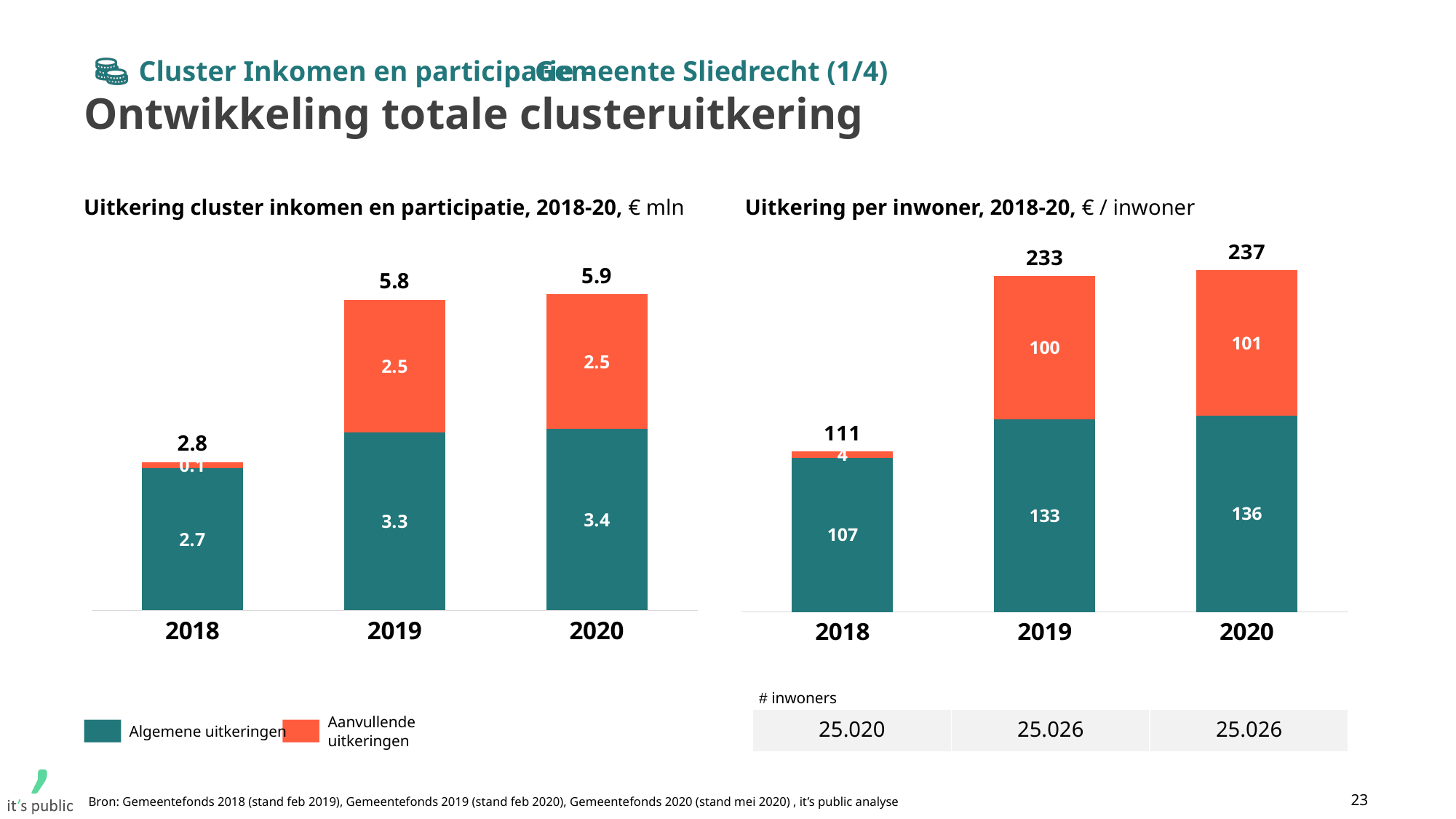
In the right chart 'Uitkering per inwoner, 2018-20', what is the difference between the totals for 2019 and 2018? 122 In the right chart 'Uitkering per inwoner, 2018-20', is the Algemene uitkeringen value for 2018 larger or smaller than the Aanvullende uitkeringen value for 2019? larger In the left chart 'Uitkering cluster inkomen en participatie, 2018-20', what is the total value for 2019? 5.8 How many years are shown on the x axis of the left chart 'Uitkering cluster inkomen en participatie, 2018-20'? 3 In the left chart 'Uitkering cluster inkomen en participatie, 2018-20', what is the value of Algemene uitkeringen for 2020? 3.4 In the left chart 'Uitkering cluster inkomen en participatie, 2018-20', what is the difference between the totals for 2020 and 2018? 3.1 What type of chart is the right chart 'Uitkering per inwoner, 2018-20'? Stacked bar chart In the right chart 'Uitkering per inwoner, 2018-20', which year has the highest total? 2020 In the right chart 'Uitkering per inwoner, 2018-20', what is the value of Aanvullende uitkeringen for 2020? 101 In the left chart 'Uitkering cluster inkomen en participatie, 2018-20', what is the value of Aanvullende uitkeringen for 2018? 0.1 In the right chart 'Uitkering per inwoner, 2018-20', what is the value of Algemene uitkeringen for 2019? 133 In the left chart 'Uitkering cluster inkomen en participatie, 2018-20', which year has the lowest total? 2018